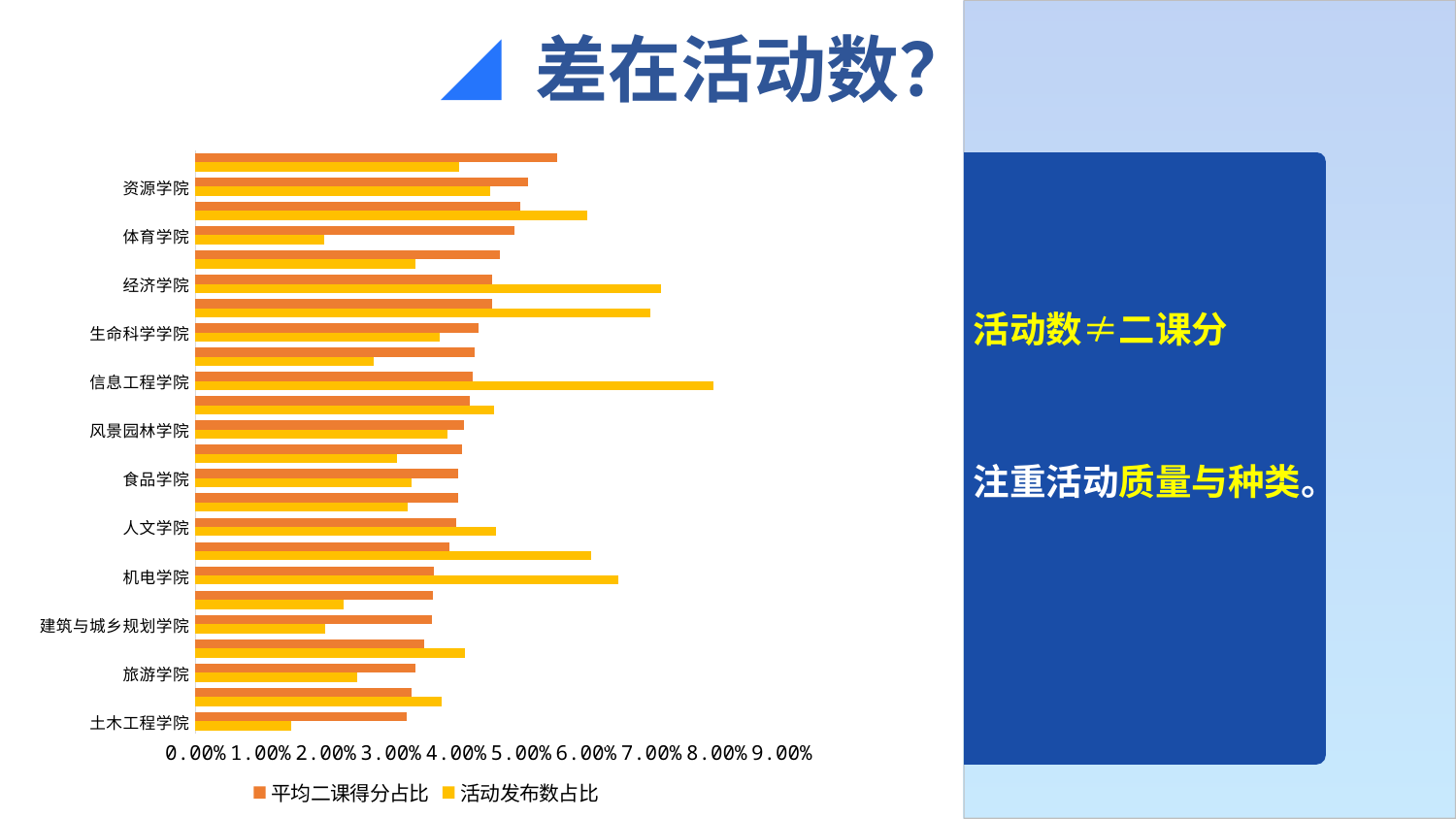
Is the 活动发布数占比 value for 经济学院 greater or less than 6.00%? greater What are the two series named in the chart legend? 平均二课得分占比 and 活动发布数占比 Is the 平均二课得分占比 value for 资源学院 greater or less than 4.00%? greater Is the 活动发布数占比 value for 体育学院 greater or less than 3.00%? less What kind of chart is shown on the slide? bar chart How many series does the chart legend list? 2 For 体育学院, which is larger: 平均二课得分占比 or 活动发布数占比? 平均二课得分占比 Which college has the highest 活动发布数占比? 信息工程学院 Which labeled college has the lowest 活动发布数占比? 土木工程学院 For 信息工程学院, which is larger: 平均二课得分占比 or 活动发布数占比? 活动发布数占比 What is the highest value shown on the chart's horizontal axis? 9.00%